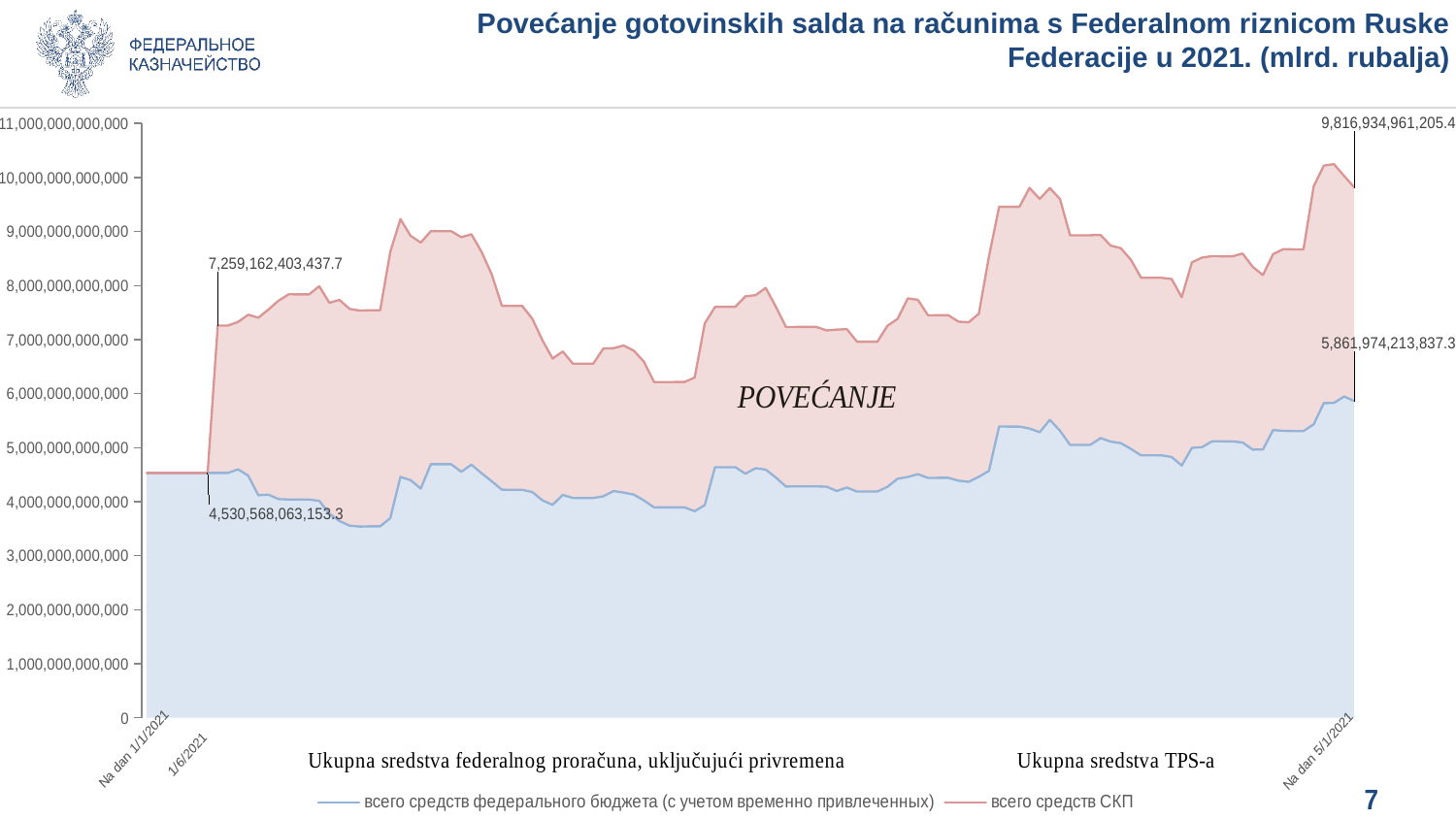
By how much did the 'всего средств СКП' series increase from 1/6/2021 to 'На дан 5/1/2021'? 2,557,772,557,767.7 What is the value of the series 'всего средств федерального бюджета (с учетом временно привлеченных)' on 'На дан 5/1/2021'? 5,861,974,213,837.3 What kind of chart is shown on the slide? Area chart What is the value of the series 'всего средств СКП' on 1/6/2021? 7,259,162,403,437.7 On 'На дан 5/1/2021', which series has the larger value: 'всего средств СКП' or 'всего средств федерального бюджета'? всего средств СКП By how much did the 'всего средств федерального бюджета' series increase from 1/6/2021 to 'На дан 5/1/2021'? 1,331,406,150,684.0 Is the value of the 'всего средств федерального бюджета' series on 'На дан 1/1/2021' greater or less than 5,000,000,000,000? less How many series does the legend list? 2 What is the value of the series 'всего средств СКП' on 'На дан 5/1/2021'? 9,816,934,961,205.4 On 'На дан 5/1/2021', what is the difference between the 'всего средств СКП' value and the 'всего средств федерального бюджета' value? 3,954,960,747,368.1 What is the value of the series 'всего средств федерального бюджета (с учетом временно привлеченных)' on 1/6/2021? 4,530,568,063,153.3 What is the title of the chart? Povećanje gotovinskih salda na računima s Federalnom riznicom Ruske Federacije u 2021. (mlrd. rubalja)